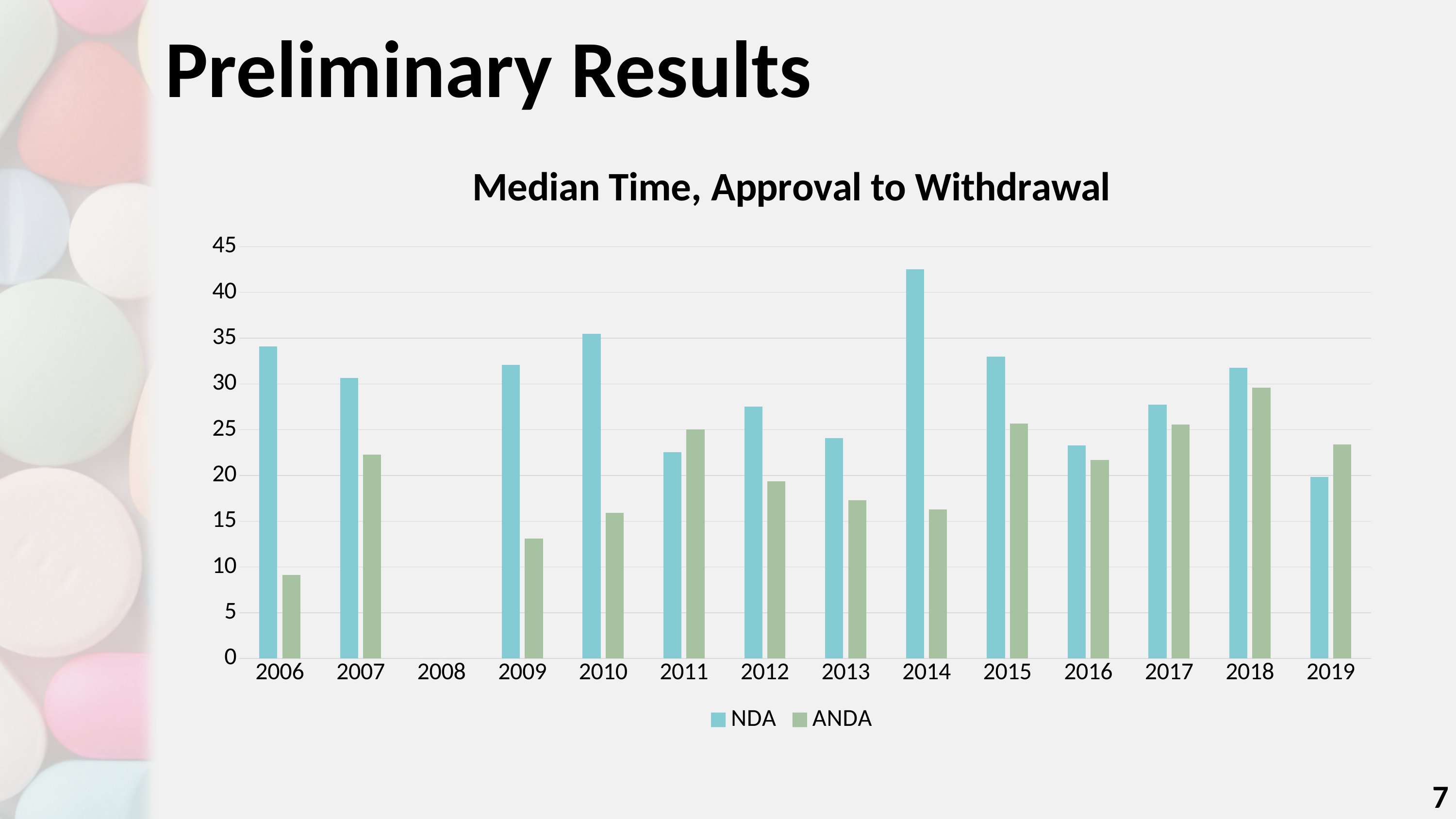
Which year has no bars plotted for either series? 2008 Is the ANDA value for 2006 greater or less than 10? less Is the NDA value for 2014 greater or less than 40? greater Which year has the highest NDA value? 2014 Is the NDA value for 2015 greater or less than 30? greater Which year has the lowest ANDA value? 2006 What is the title of the chart? Median Time, Approval to Withdrawal How many years are shown on the x axis? 14 Which year has the highest ANDA value? 2018 How many series does the legend list? 2 In 2011, which series has the larger value, NDA or ANDA? ANDA What kind of chart is shown on the slide? bar chart